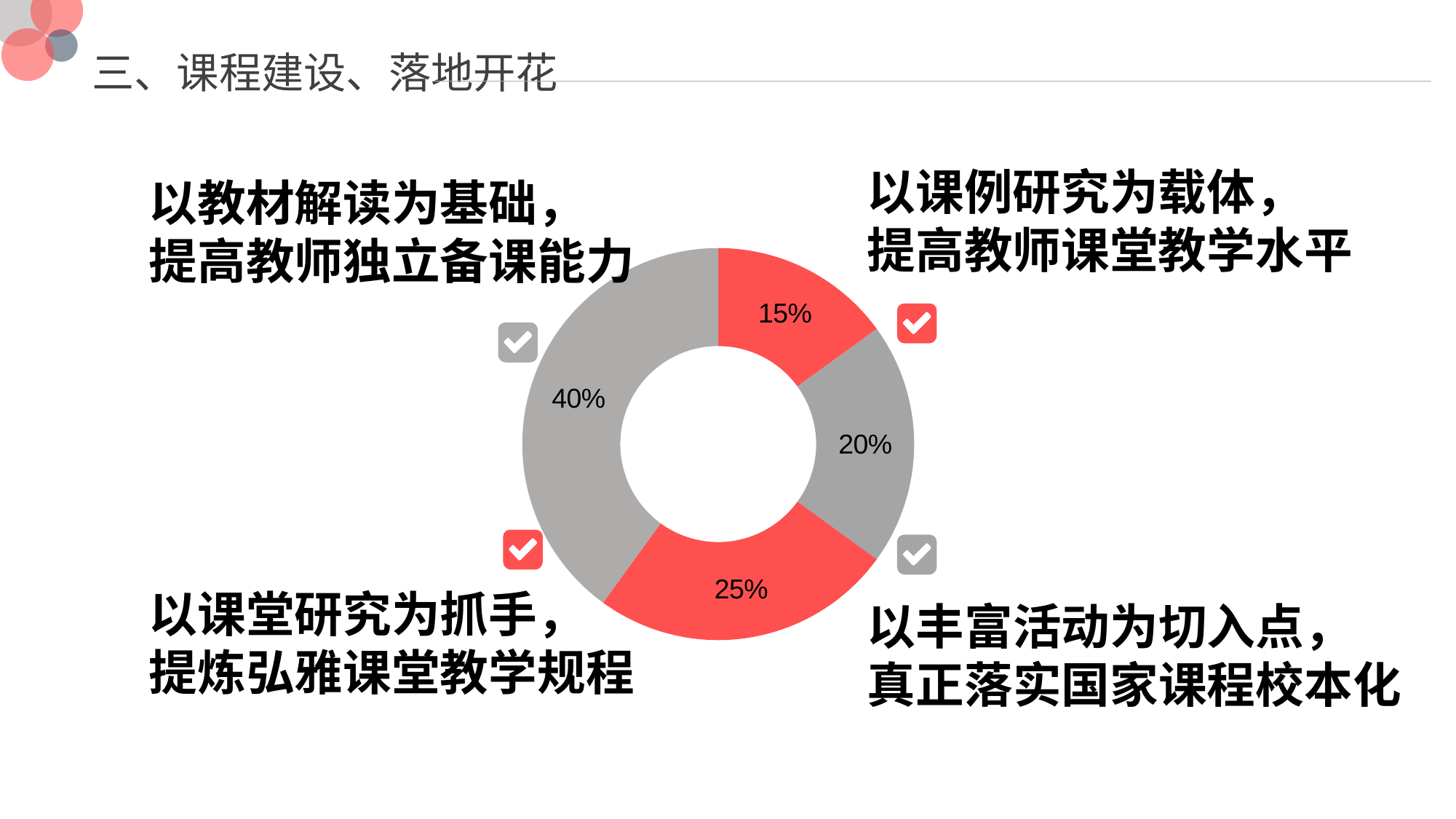
What is the value of the slice on the right side of the donut chart? 20% Which two slice values are coloured red in the donut chart? 15% and 25% What is the value of the smallest slice in the donut chart? 15% What is the value of the largest slice in the donut chart? 40% What kind of chart is shown on the slide? Pie chart (donut) What is the difference between the largest slice (40%) and the smallest slice (15%)? 25 percentage points What colour is the 40% slice of the donut chart? Grey What do the four slices of the donut chart add up to? 100% What is the value of the slice at the top right of the donut chart, just clockwise from the top? 15% What is the value of the slice at the bottom of the donut chart? 25% How many slices does the donut chart have? 4 Which is larger, the 20% slice or the 25% slice? The 25% slice